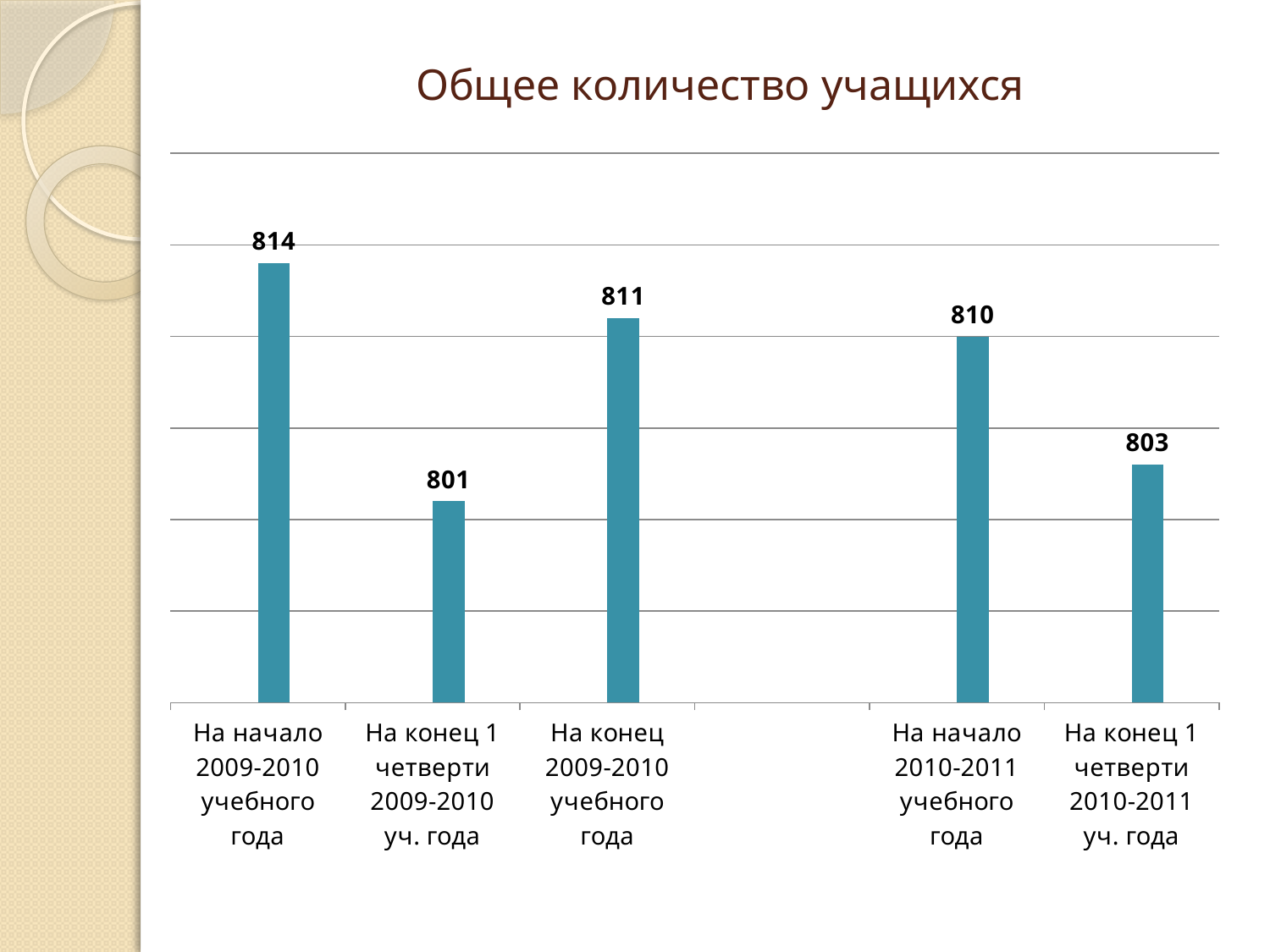
What is the value for "На конец 1 четверти 2010-2011 уч. года"? 803 Which category has the highest value? На начало 2009-2010 учебного года What is the value for "На начало 2009-2010 учебного года"? 814 How many bars are plotted in the chart? 5 Which category has the lowest value? На конец 1 четверти 2009-2010 уч. года What is the title of the chart? Общее количество учащихся What is the difference between the values for "На начало 2009-2010 учебного года" and "На конец 1 четверти 2009-2010 уч. года"? 13 What kind of chart is shown on the slide? Bar chart Which is larger: the value for "На начало 2010-2011 учебного года" or "На конец 1 четверти 2010-2011 уч. года"? На начало 2010-2011 учебного года What is the value for "На начало 2010-2011 учебного года"? 810 What is the value for "На конец 2009-2010 учебного года"? 811 What is the value for "На конец 1 четверти 2009-2010 уч. года"? 801